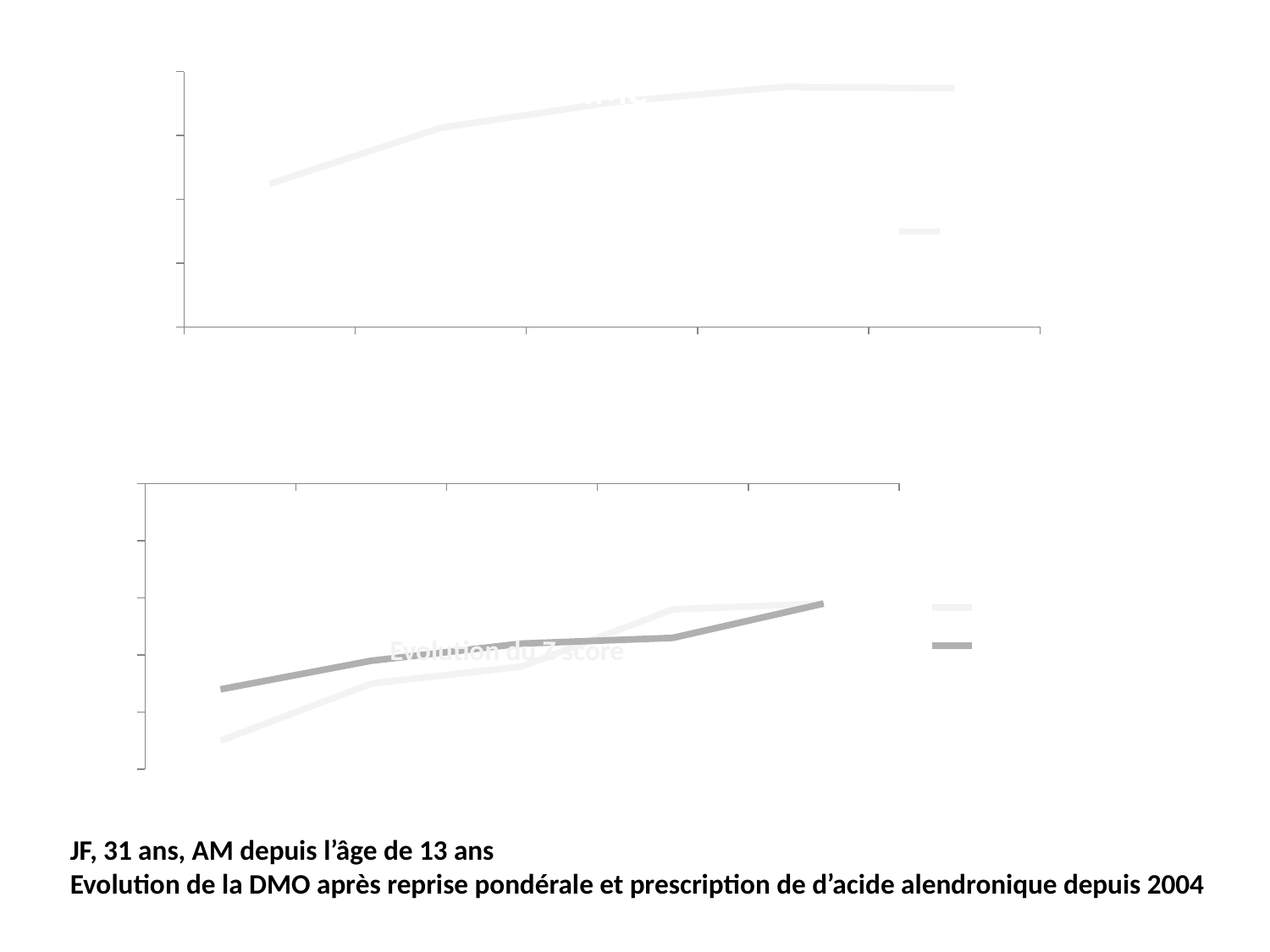
In the bottom chart, at the first point on the left, which line is higher: the darker gray line or the lighter line? the darker gray line What kind of chart is the bottom chart on the slide? line chart What kind of chart is the top chart on the slide? line chart In the bottom chart, do the values of the lighter line rise or fall along the x axis? rise In the top chart, do the values rise or fall along the x axis? rise How many series does the legend of the bottom chart list? 2 In the bottom chart, do the values of the darker gray line rise or fall along the x axis? rise What is the title of the bottom chart? Evolution du Z-score How many lines are plotted in the bottom chart? 2 How many series does the legend of the top chart list? 1